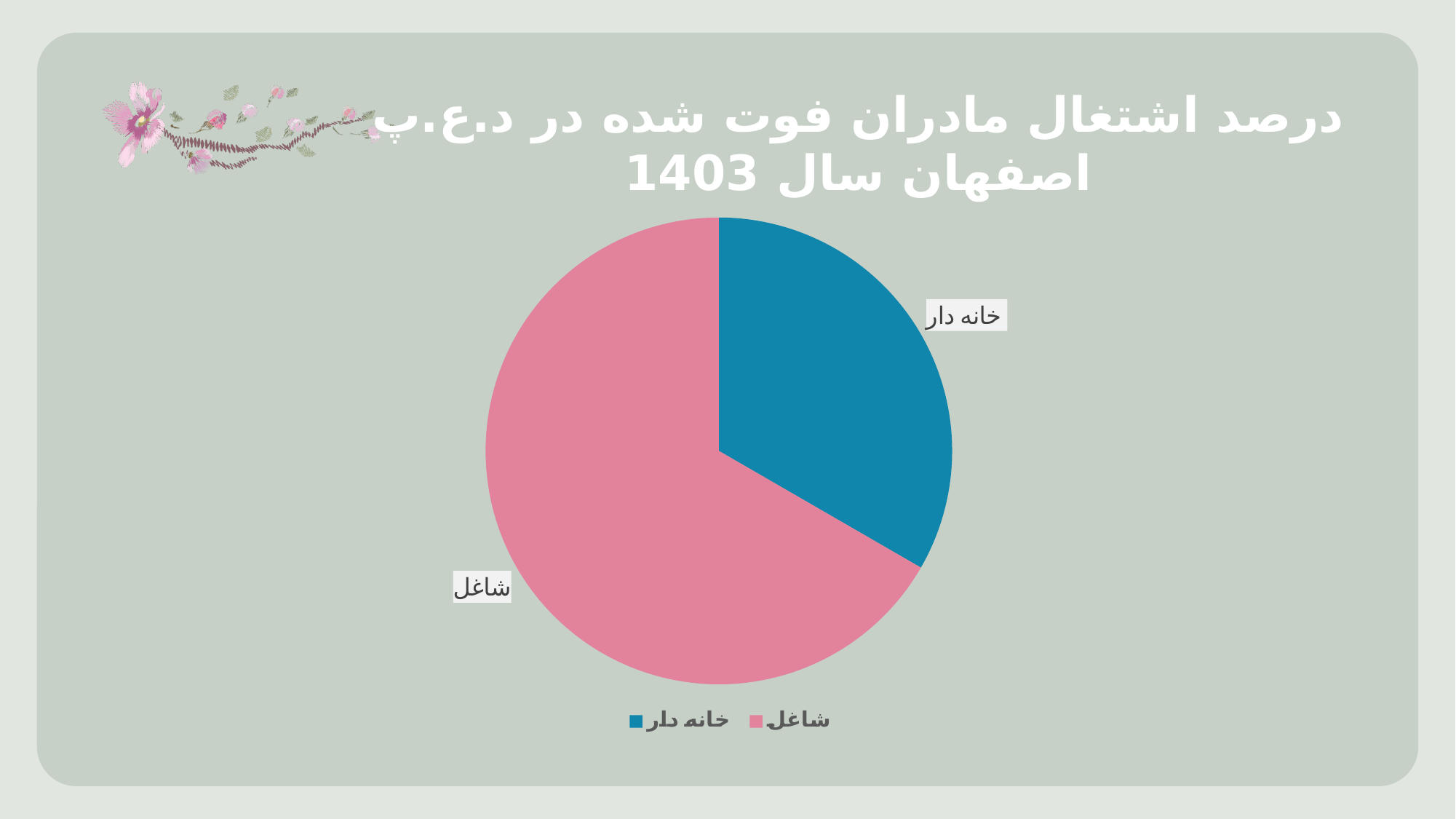
What colour is the slice for خانه دار in the pie chart? blue Which category has the smallest slice of the pie chart? خانه دار Which category has the largest slice of the pie chart? شاغل How many entries does the legend of the pie chart list? 2 How many slices does the pie chart have? 2 What kind of chart is shown on the slide? pie chart What is the title of the chart on the slide? درصد اشتغال مادران فوت شده در د.ع.پ اصفهان سال 1403 Which slice is larger, شاغل or خانه دار? شاغل